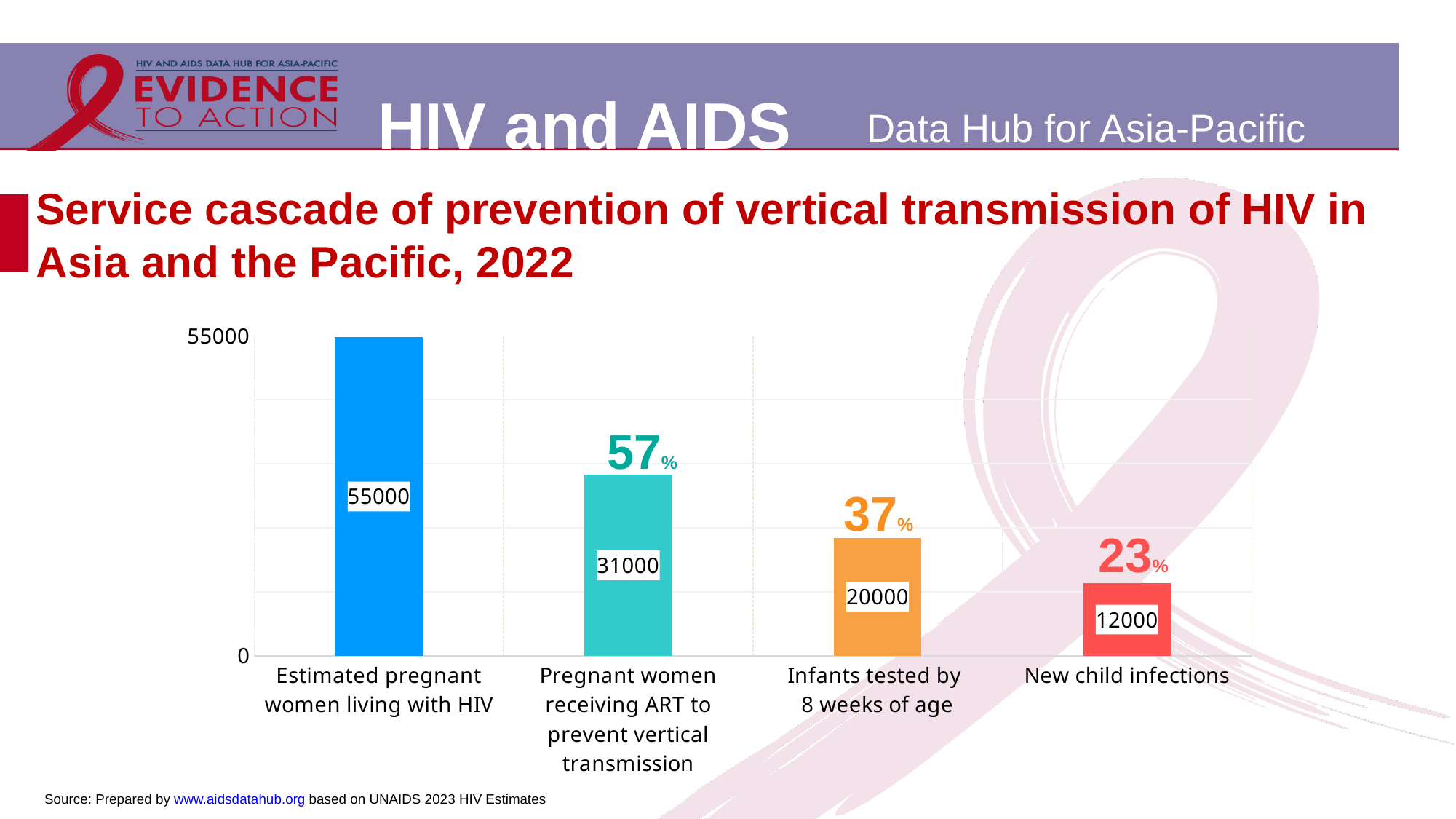
How many categories are shown on the chart? 4 What is the value for Pregnant women receiving ART to prevent vertical transmission? 31000 Which is larger: the value for Infants tested by 8 weeks of age or the value for New child infections? Infants tested by 8 weeks of age Which category has the lowest value? New child infections What is the value for Infants tested by 8 weeks of age? 20000 Do the values rise or fall from left to right along the x axis? Fall Which category has the highest value? Estimated pregnant women living with HIV What is the value for New child infections? 12000 What is the value for Estimated pregnant women living with HIV? 55000 What is the difference between the values for Estimated pregnant women living with HIV and Pregnant women receiving ART to prevent vertical transmission? 24000 What percentage is shown above the bar for Infants tested by 8 weeks of age? 37% What kind of chart is shown on the slide? Bar chart